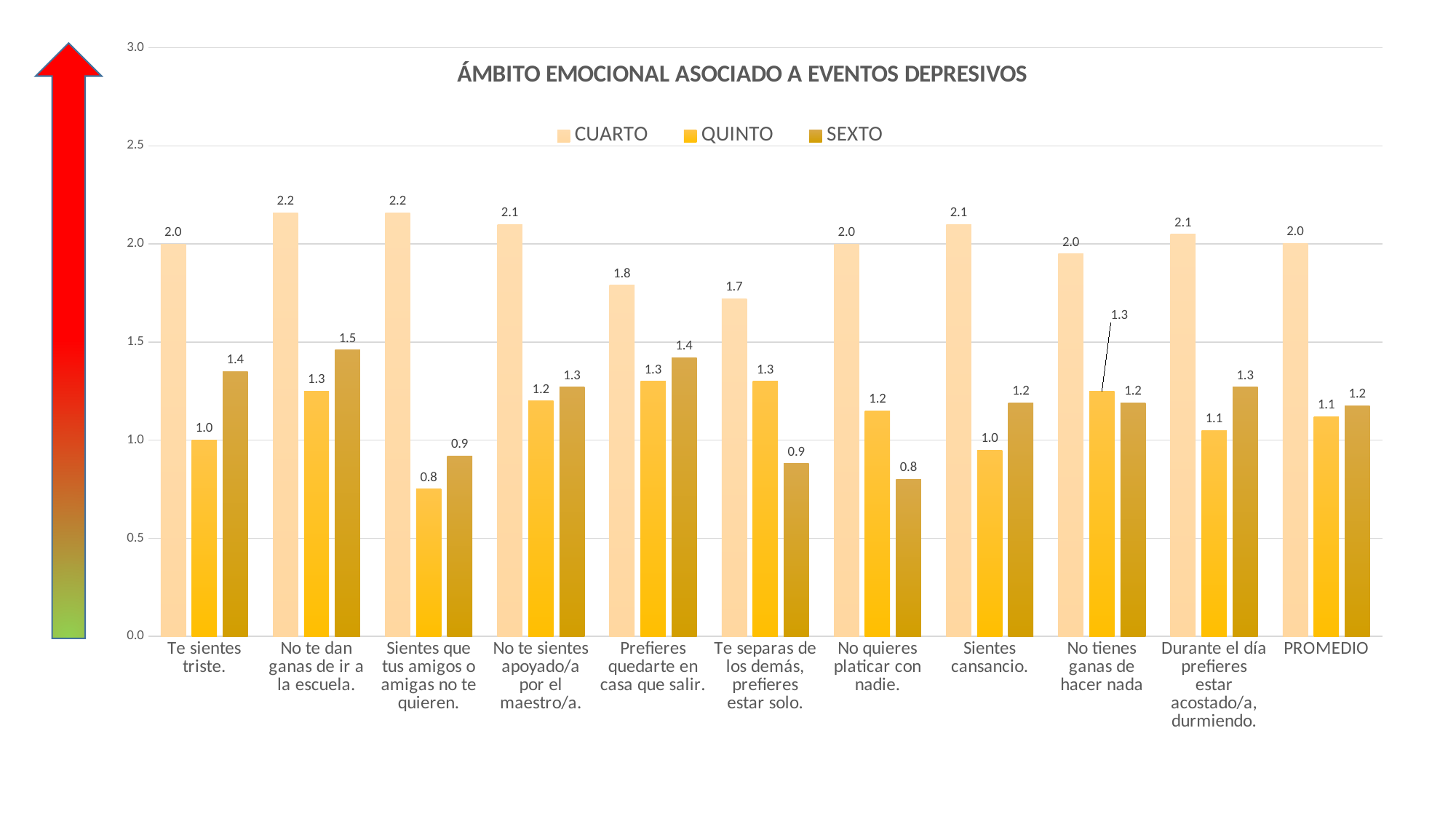
How many categories are shown on the x axis? 11 What is the QUINTO value for "Prefieres quedarte en casa que salir."? 1.3 What is the QUINTO value for PROMEDIO? 1.1 Which category has the highest SEXTO value? No te dan ganas de ir a la escuela. What kind of chart is shown on the slide? Bar chart What is the difference between the CUARTO and QUINTO values for "Sientes que tus amigos o amigas no te quieren."? 1.4 What is the CUARTO value for "Te sientes triste."? 2.0 What is the SEXTO value for "No te dan ganas de ir a la escuela."? 1.5 How many series does the legend list? 3 Which category has the lowest QUINTO value? Sientes que tus amigos o amigas no te quieren. For "Te separas de los demás, prefieres estar solo.", which is larger, the QUINTO value or the SEXTO value? QUINTO What is the title of the chart? ÁMBITO EMOCIONAL ASOCIADO A EVENTOS DEPRESIVOS